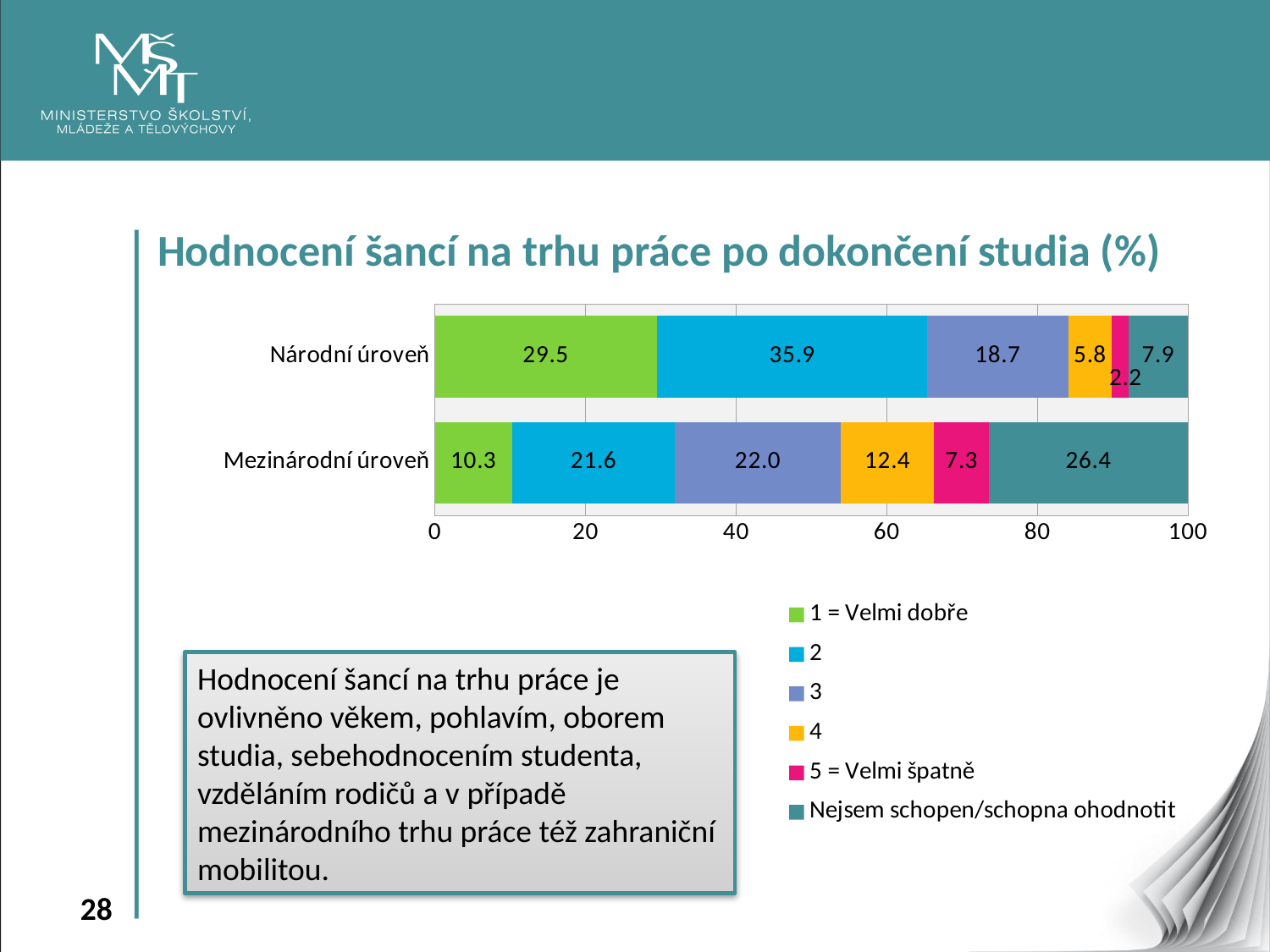
What is the title of the chart? Hodnocení šancí na trhu práce po dokončení studia (%) What is the difference between the "1 = Velmi dobře" values for Národní úroveň and Mezinárodní úroveň? 19.2 What is the value for "Nejsem schopen/schopna ohodnotit" in the Mezinárodní úroveň bar? 26.4 What is the value for "1 = Velmi dobře" in the Národní úroveň bar? 29.5 How many categories (bars) are shown in the chart? 2 Which series has the smallest segment in the Mezinárodní úroveň bar? 5 = Velmi špatně Which series has the largest segment in the Národní úroveň bar? 2 What is the value for "5 = Velmi špatně" in the Národní úroveň bar? 2.2 What type of chart is shown on the slide? Stacked bar chart Which bar has the larger value for series "4", Národní úroveň or Mezinárodní úroveň? Mezinárodní úroveň What is the value for series "3" in the Mezinárodní úroveň bar? 22.0 How many series does the legend list? 6